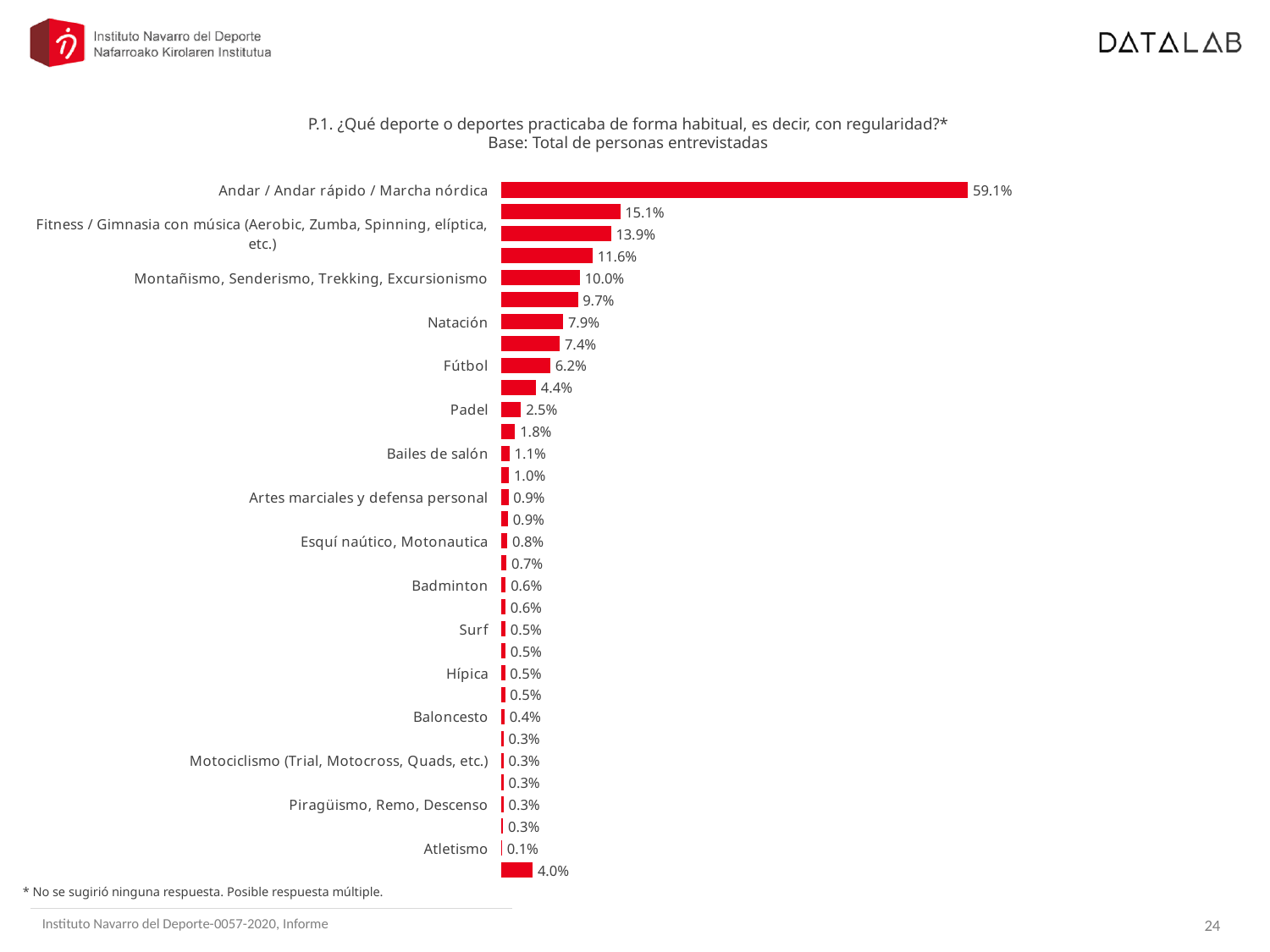
What is the difference between the percentages for Natación and Fútbol? 1.7% What percentage is shown for Andar / Andar rápido / Marcha nórdica? 59.1% What percentage is shown for Atletismo? 0.1% What is the base stated under the chart title? Total de personas entrevistadas What is the difference between the percentages for Montañismo, Senderismo, Trekking, Excursionismo and Padel? 7.5% Which sport has the highest percentage in the chart? Andar / Andar rápido / Marcha nórdica What type of chart is shown on the slide? Bar chart What percentage is shown for Padel? 2.5% What percentage is shown for Natación? 7.9% What percentage is shown for Fútbol? 6.2% Which has a higher percentage, Natación or Fútbol? Natación What percentage is shown for Montañismo, Senderismo, Trekking, Excursionismo? 10.0%